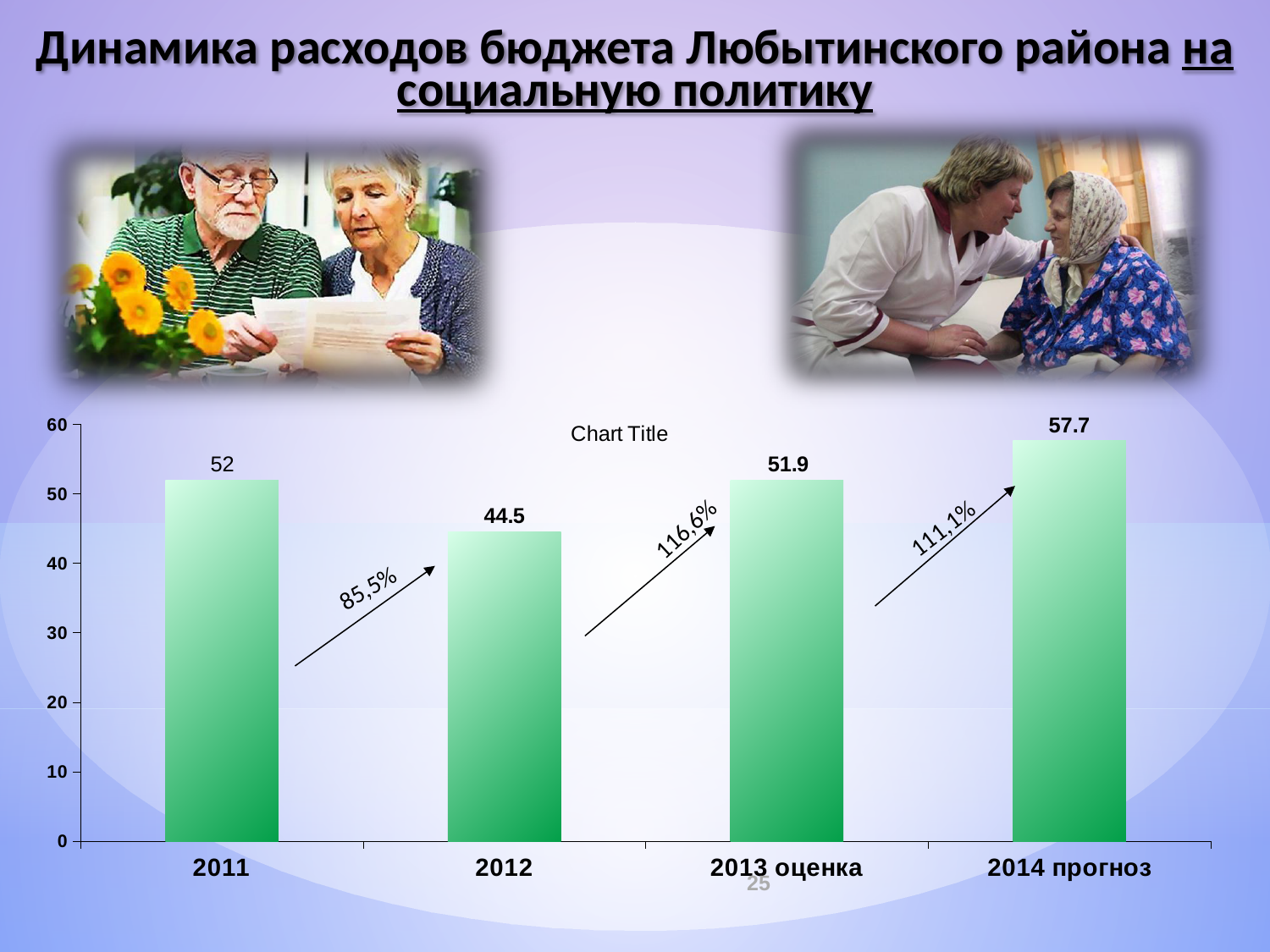
Which is larger, the value for 2011 or the value for 2012? 2011 How many categories are shown on the x axis? 4 What is the difference between the values for 2011 and 2012? 7.5 What is the value for 2013 оценка? 51.9 What is the value for 2014 прогноз? 57.7 What is the value for 2011? 52 What is the difference between the values for 2014 прогноз and 2012? 13.2 What kind of chart is shown on the slide? bar chart What is the value for 2012? 44.5 What percentage is written on the arrow between the 2012 and 2013 оценка bars? 116,6% Which category has the highest value? 2014 прогноз Which category has the lowest value? 2012